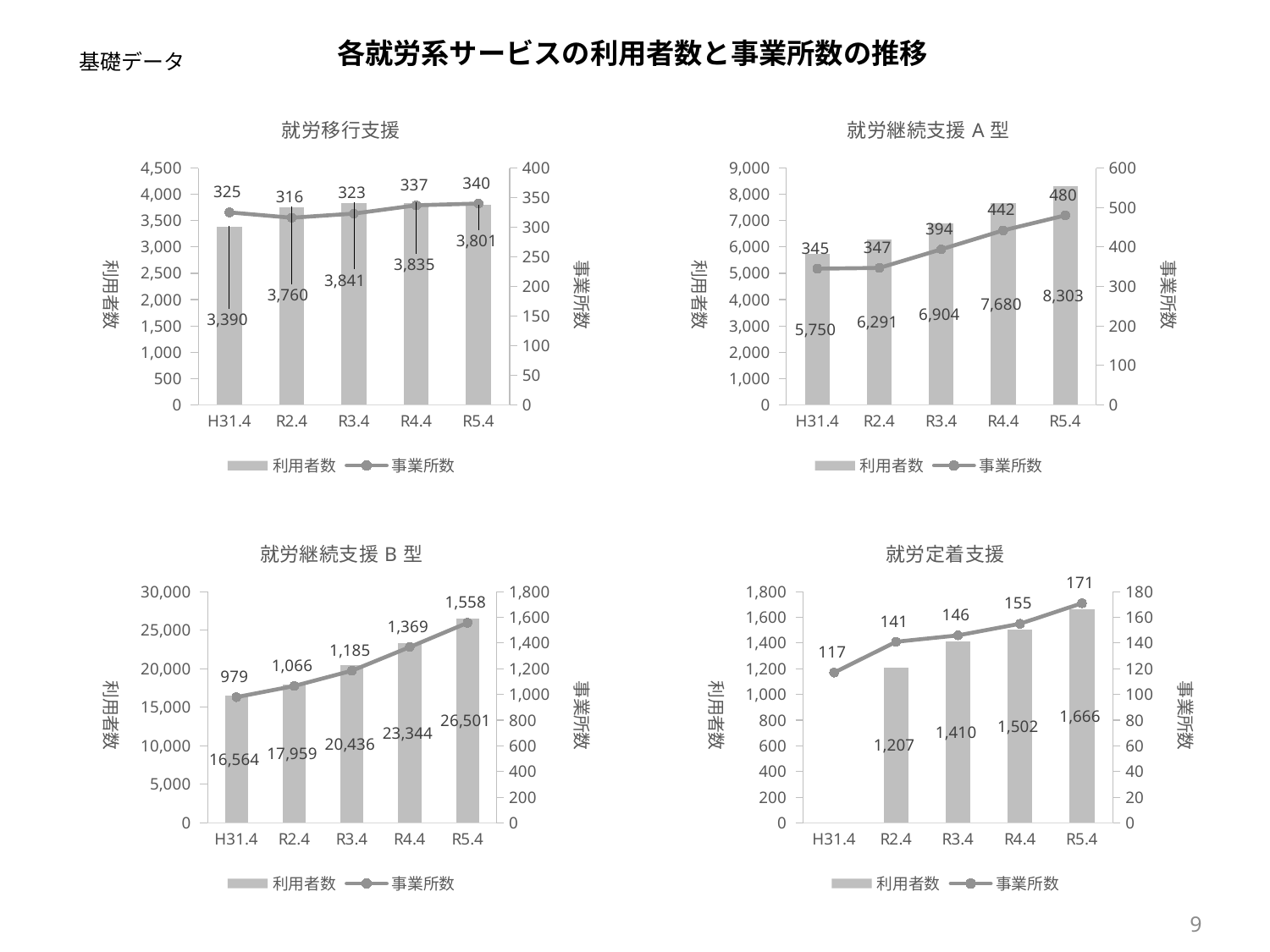
How many charts are shown on the slide? 4 In the 就労継続支援 B 型 chart, which period has the lowest 事業所数? H31.4 In the 就労定着支援 chart, what is the 事業所数 value for H31.4? 117 In the 就労移行支援 chart, what is the 利用者数 value for H31.4? 3,390 In the 就労定着支援 chart, which is larger, the 利用者数 for R3.4 or for R4.4? R4.4 In the 就労継続支援 B 型 chart, what is the difference in 事業所数 between R5.4 and R4.4? 189 In the 就労継続支援 A 型 chart, does 利用者数 rise or fall from H31.4 to R5.4? rise In the 就労継続支援 B 型 chart, what is the 利用者数 value for R3.4? 20,436 In the 就労継続支援 A 型 chart, what is the 事業所数 value for R4.4? 442 In the 就労継続支援 A 型 chart, what is the difference in 利用者数 between R5.4 and H31.4? 2,553 In the 就労移行支援 chart, which period has the highest 事業所数? R5.4 How many series does the legend of the 就労移行支援 chart list? 2